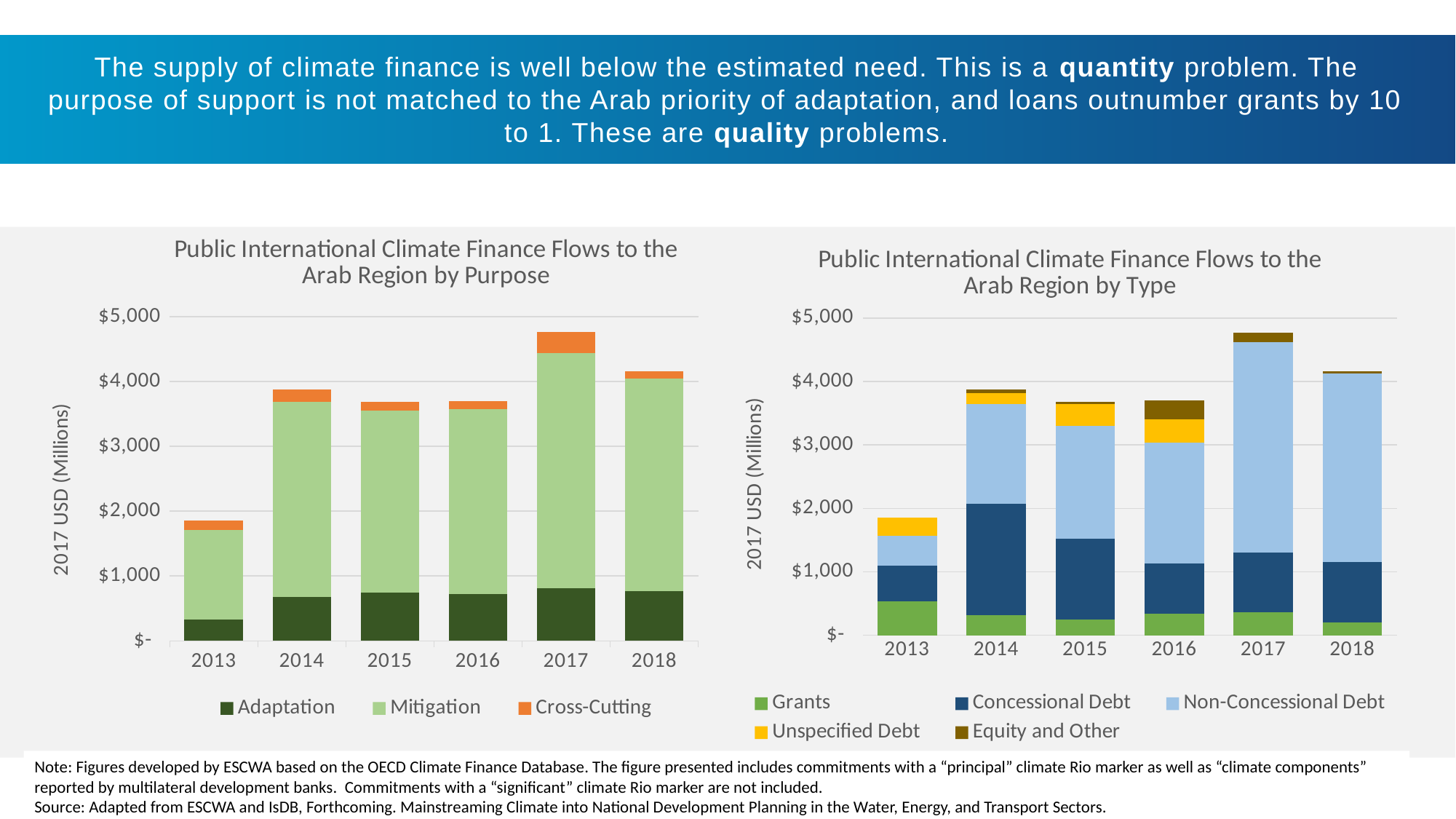
In the 'by Type' chart, which series is shown in light blue? Non-Concessional Debt What kind of chart is the 'Public International Climate Finance Flows to the Arab Region by Purpose' chart? Stacked bar chart In the 'by Type' chart, is the total for 2017 greater or less than $4,000? greater In the 'by Type' chart, which year has the lowest total bar? 2013 In the 'by Purpose' chart, is the Adaptation value for 2013 greater or less than $1,000? less In the 'by Purpose' chart, which is larger, the total for 2013 or the total for 2014? 2014 In the 'by Purpose' chart, which year has the highest total bar? 2017 How many series does the legend of the 'by Purpose' chart list? 3 In the 'by Purpose' chart, how many years are shown on the x axis? 6 What is the y-axis label of the 'by Type' chart? 2017 USD (Millions) How many series does the legend of the 'by Type' chart list? 5 In the 'by Purpose' chart, is the total for 2013 greater or less than $2,000? less